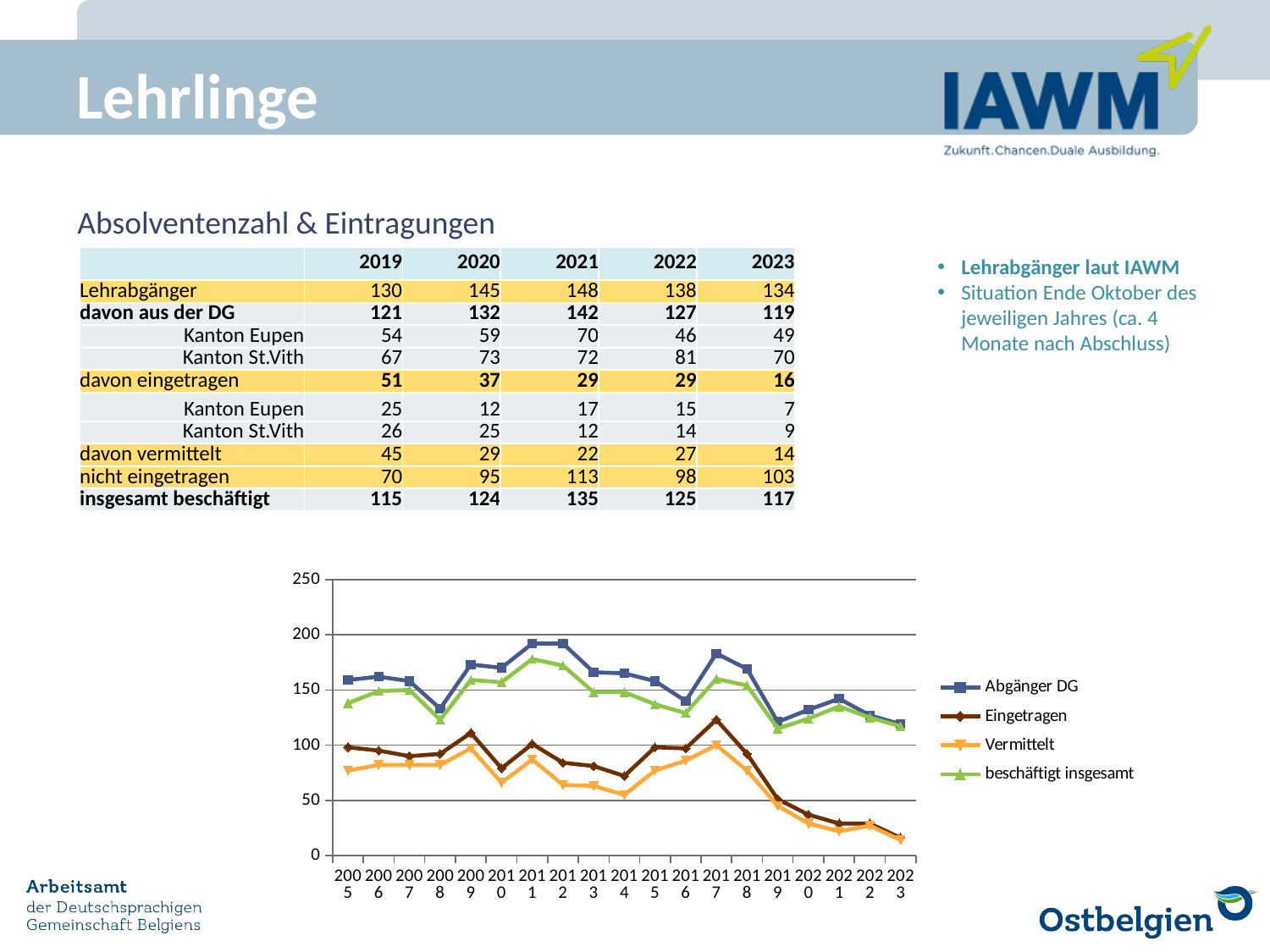
How many years are plotted along the x axis of the chart? 19 Which is larger: the Abgänger DG value in 2011 or in 2019? 2011 How many series does the chart's legend list? 4 In which year does the Eingetragen series reach its highest value? 2017 Is the value for Eingetragen in 2023 greater or less than 50? less What kind of chart is shown on the slide? line chart Does the Eingetragen series rise or fall from 2017 to 2023? fall Is the value for Eingetragen in 2017 greater or less than 100? greater Is the value for beschäftigt insgesamt in 2008 greater or less than 150? less In which year does the Vermittelt series reach its lowest value? 2023